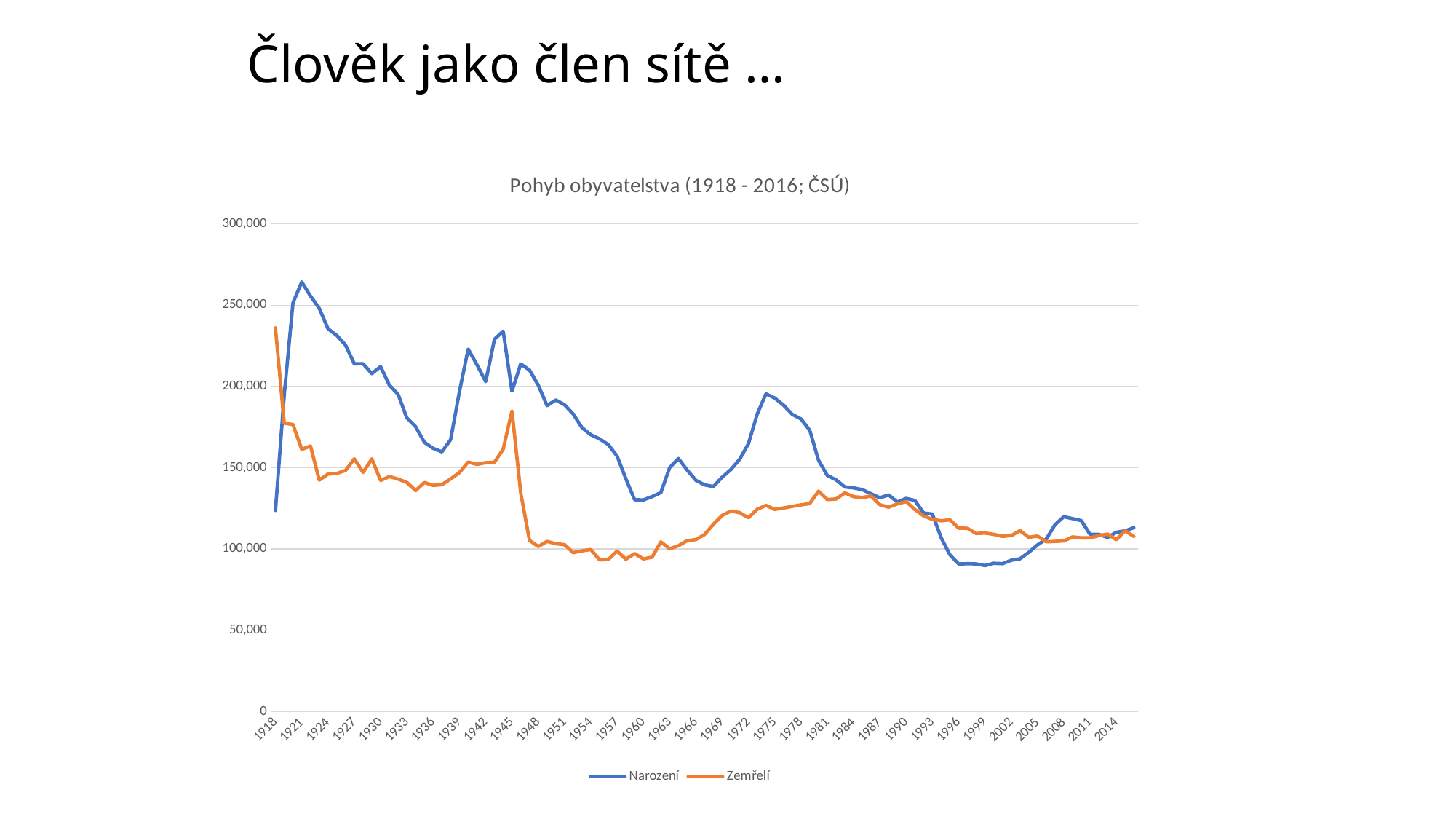
In which year does the Narození series reach its highest value? 1921 In which year does the Zemřelí series reach its highest value? 1918 What kind of chart is shown on the slide? line chart Is the value for Narození in 1999 greater or less than 100,000? less Which series has the larger value in 1975, Narození or Zemřelí? Narození Does the Narození series rise or fall between 1975 and 1999? fall Is the value for Narození in 1921 greater or less than 250,000? greater Which series has the larger value in 1918, Narození or Zemřelí? Zemřelí How many series does the legend list? 2 Which colour is used for the Zemřelí series? orange What is the title of the chart? Pohyb obyvatelstva (1918 - 2016; ČSÚ)